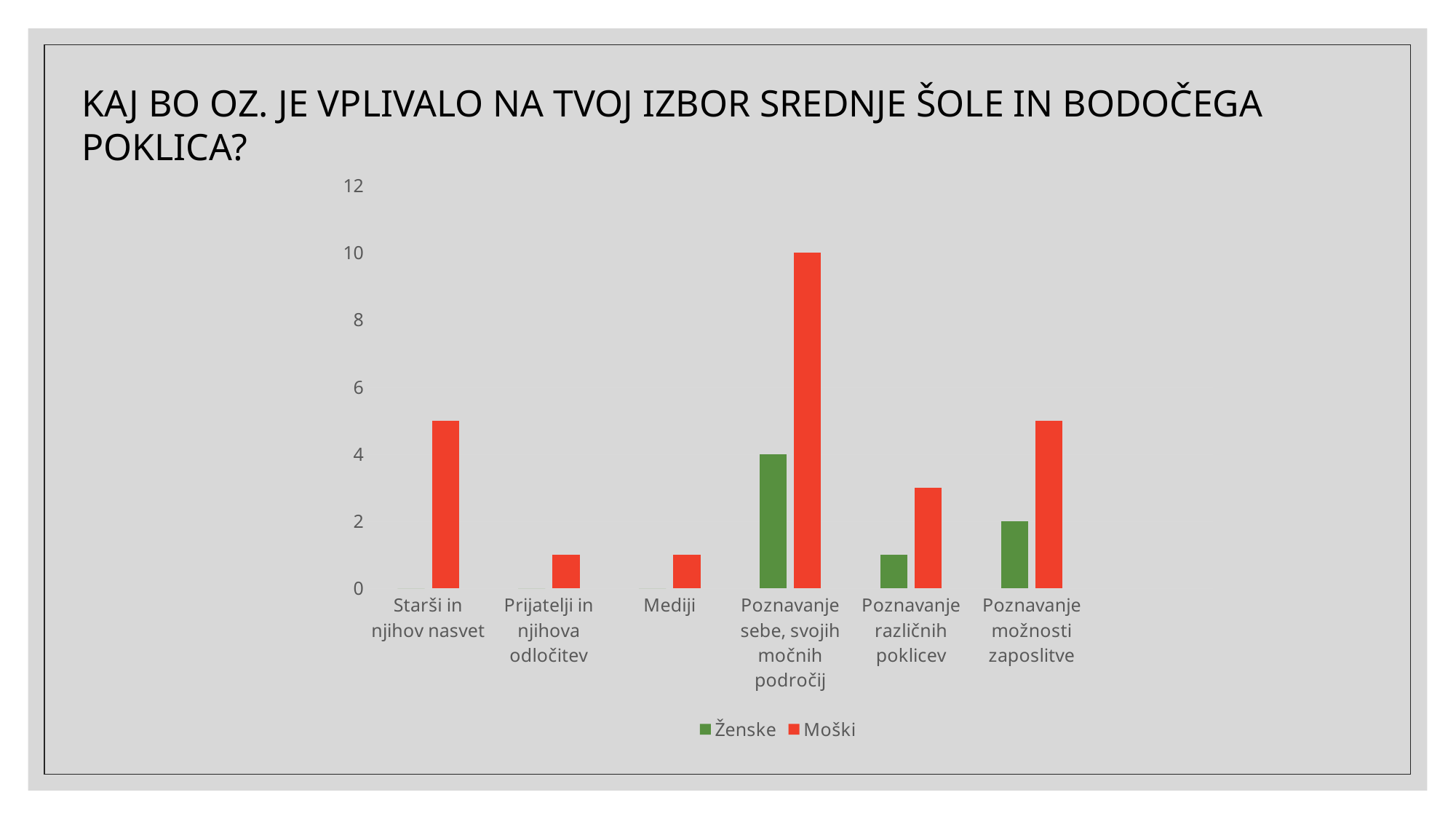
Which colour represents the Ženske series in the legend? green How many categories are shown on the x axis? 6 What is the value for Moški in the category 'Poznavanje sebe, svojih močnih področij'? 10 Is the value for Moški in 'Starši in njihov nasvet' greater or less than 4? greater What type of chart is shown on the slide? bar chart What is the difference between the Moški and Ženske values for 'Poznavanje sebe, svojih močnih področij'? 6 Which category has the highest value for Moški? Poznavanje sebe, svojih močnih področij What is the value for Ženske in the category 'Poznavanje sebe, svojih močnih področij'? 4 What is the value for Ženske in the category 'Poznavanje možnosti zaposlitve'? 2 Is the value for Moški in 'Poznavanje različnih poklicev' greater or less than 4? less How many series does the legend list? 2 Which category has the highest value for Ženske? Poznavanje sebe, svojih močnih področij